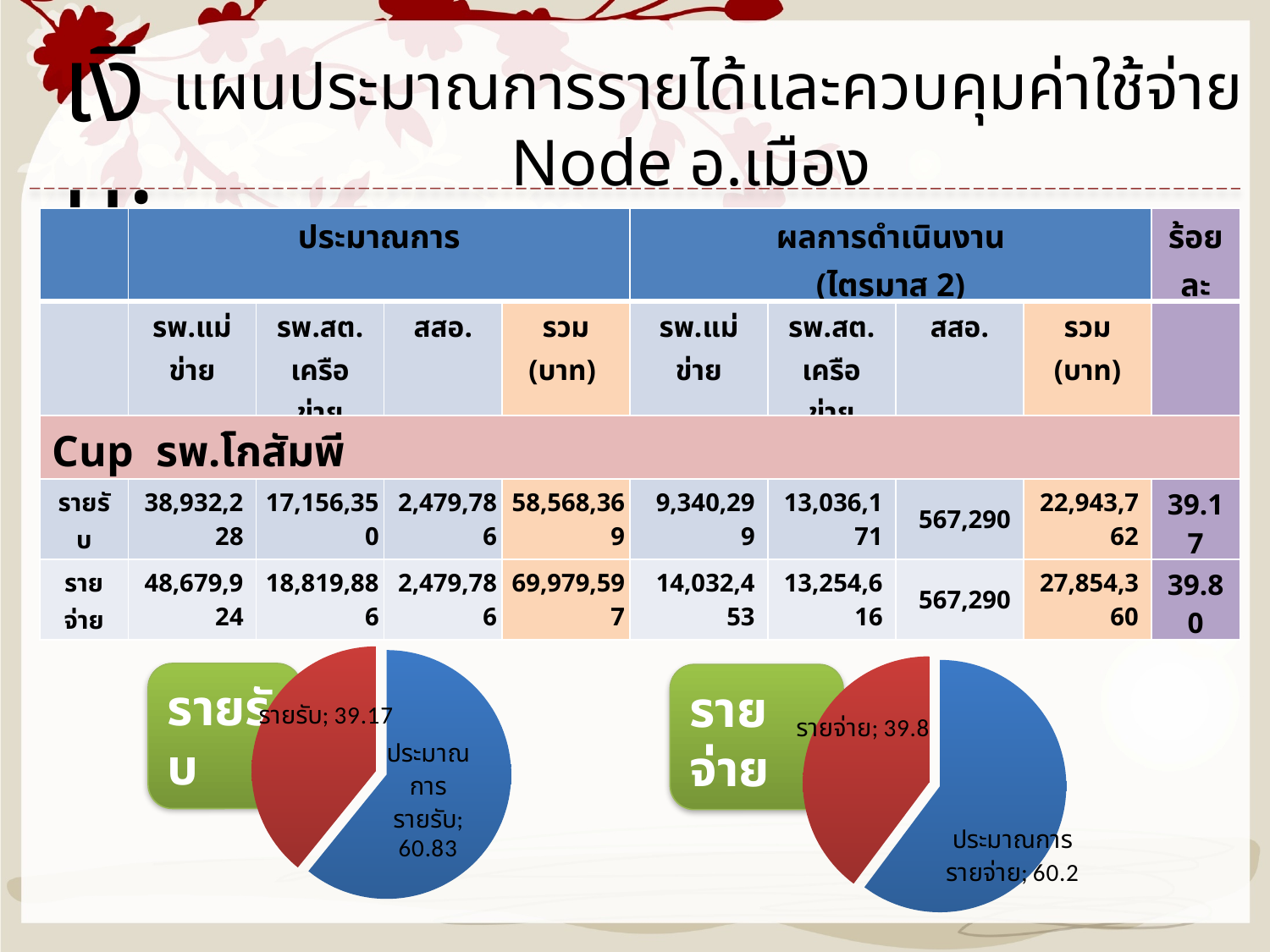
What kind of chart is the left chart labelled รายรับ? pie chart In the left pie chart (รายรับ), what is the value of the slice labelled ประมาณการรายรับ? 60.83 In the left pie chart (รายรับ), which slice is the largest? ประมาณการรายรับ In the left pie chart (รายรับ), what is the difference between the ประมาณการรายรับ slice and the รายรับ slice? 21.66 How many slices does the right pie chart (รายจ่าย) have? 2 In the left pie chart (รายรับ), what is the value of the slice labelled รายรับ? 39.17 In the right pie chart (รายจ่าย), which is larger: the รายจ่าย slice or the ประมาณการรายจ่าย slice? ประมาณการรายจ่าย In the right pie chart (รายจ่าย), what is the value of the slice labelled รายจ่าย? 39.8 In the right pie chart (รายจ่าย), what is the difference between the ประมาณการรายจ่าย slice and the รายจ่าย slice? 20.4 In the left pie chart (รายรับ), what colour is the slice labelled รายรับ? red In the right pie chart (รายจ่าย), what is the value of the slice labelled ประมาณการรายจ่าย? 60.2 In the right pie chart (รายจ่าย), which slice is the smallest? รายจ่าย